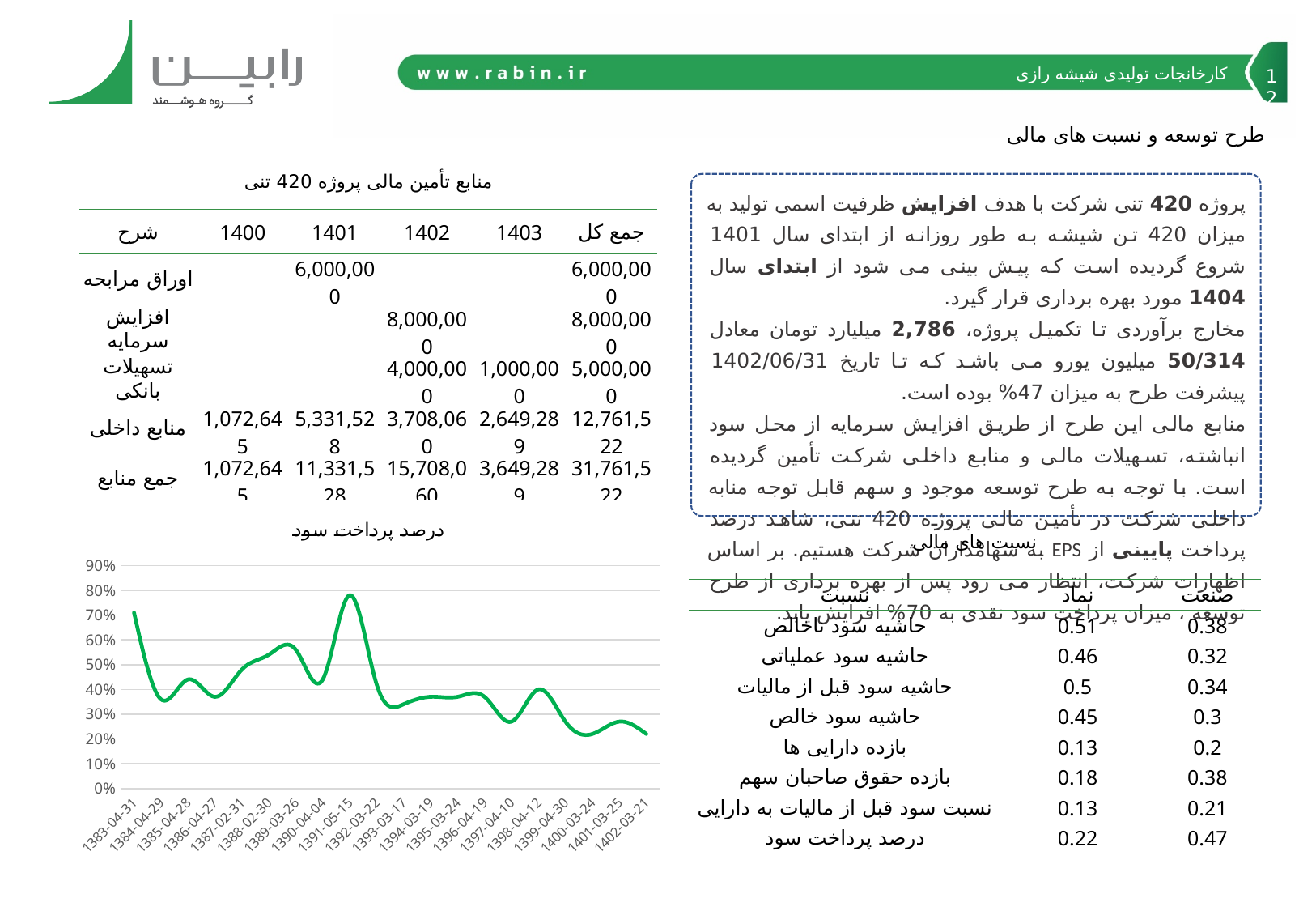
In the "درصد پرداخت سود" chart, which is larger: the value for 1383-04-31 or the value for 1402-03-21? 1383-04-31 Overall, does the line in the "درصد پرداخت سود" chart rise or fall from 1383-04-31 to 1402-03-21? fall How many dated points are labelled on the x axis of the "درصد پرداخت سود" chart? 20 In the "درصد پرداخت سود" chart, is the value for 1383-04-31 greater or less than 60%? greater In the "درصد پرداخت سود" chart, which is larger: the value for 1391-05-15 or the value for 1389-03-26? 1391-05-15 In the "درصد پرداخت سود" chart, is the value for 1402-03-21 greater or less than 30%? less What is the title of the chart on the slide? درصد پرداخت سود In the "درصد پرداخت سود" chart, at which date does the line reach its highest value? 1391-05-15 In the "درصد پرداخت سود" chart, is the value for 1391-05-15 greater or less than 70%? greater What kind of chart is shown under the title "درصد پرداخت سود"? line chart